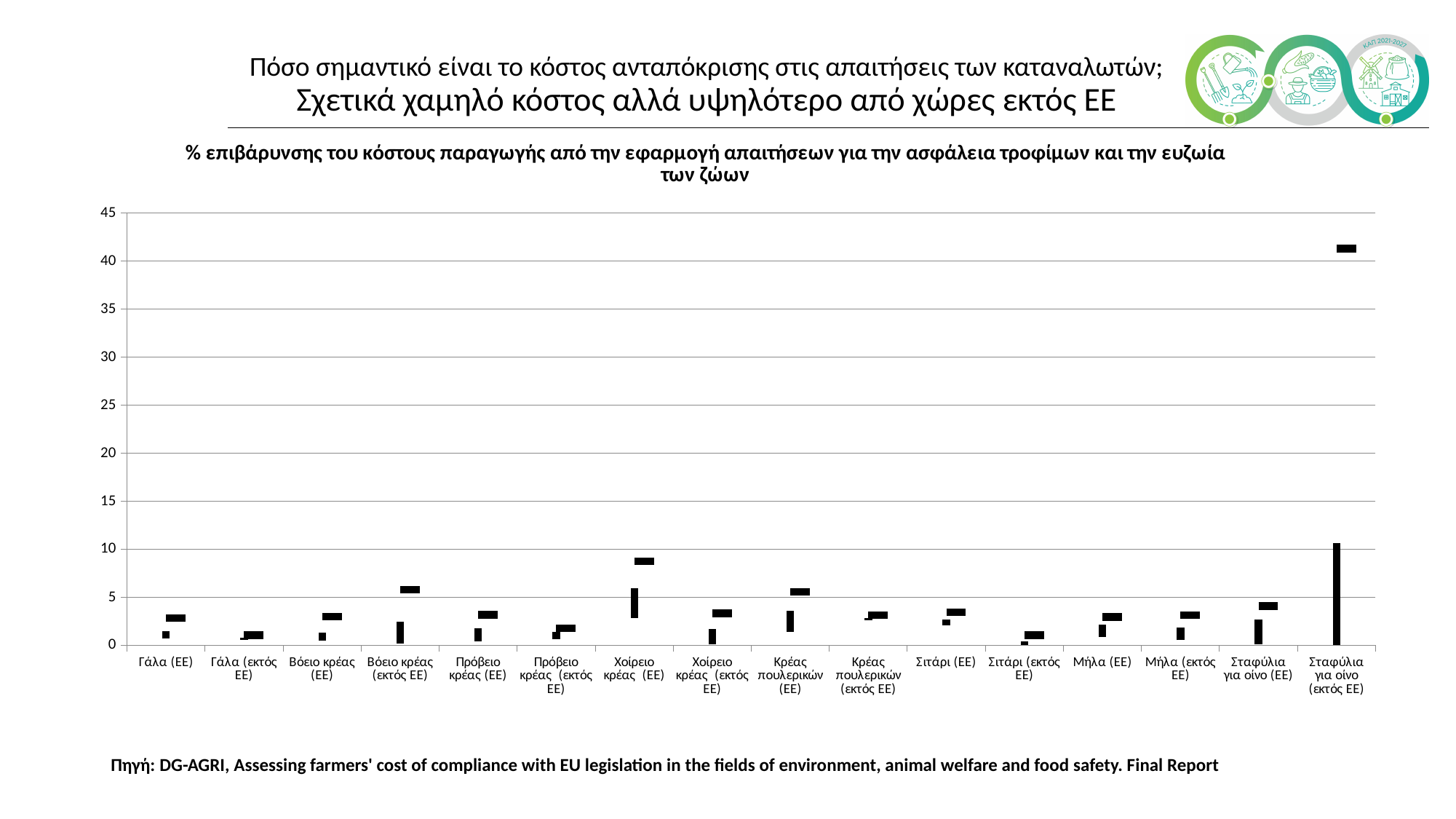
Which has the higher value: Χοίρειο κρέας (ΕΕ) or Γάλα (εκτός ΕΕ)? Χοίρειο κρέας (ΕΕ) What is the title of the chart? % επιβάρυνσης του κόστους παραγωγής από την εφαρμογή απαιτήσεων για την ασφάλεια τροφίμων και την ευζωία των ζώων Is the highest value for Σταφύλια για οίνο (εκτός ΕΕ) greater or less than 30? greater Is the highest value for Βόειο κρέας (εκτός ΕΕ) greater or less than 10? less Is the highest value for Χοίρειο κρέας (ΕΕ) greater or less than 10? less Which has the higher value: Σταφύλια για οίνο (εκτός ΕΕ) or Γάλα (ΕΕ)? Σταφύλια για οίνο (εκτός ΕΕ) How many categories are shown on the x axis of the chart? 16 Which category has the highest value in the chart? Σταφύλια για οίνο (εκτός ΕΕ) What is the maximum value shown on the y axis of the chart? 45